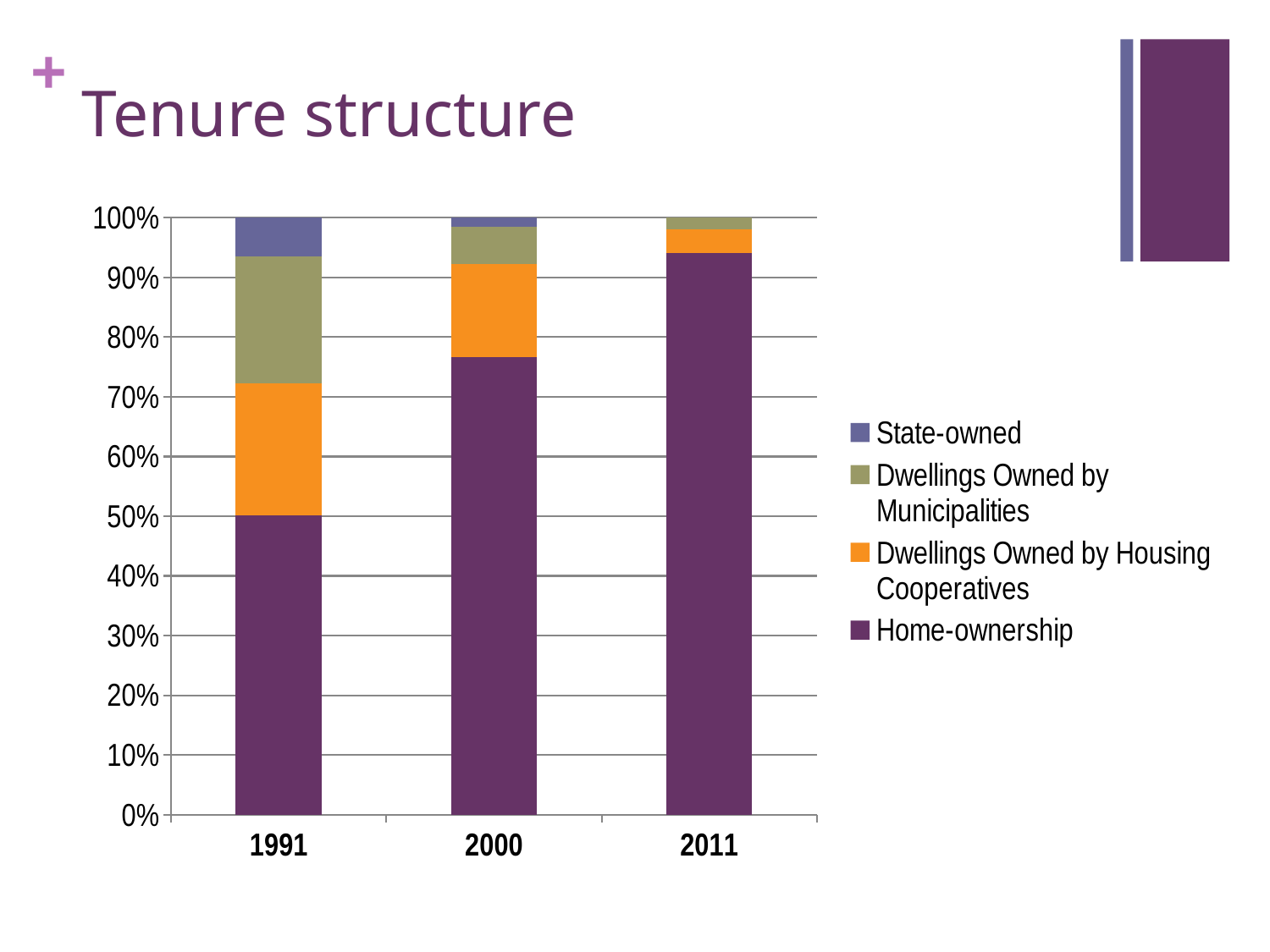
Which year has the larger State-owned share, 1991 or 2000? 1991 What is the title of the slide containing the chart? Tenure structure Which series is shown in orange in the chart? Dwellings Owned by Housing Cooperatives What kind of chart is shown on the slide? stacked bar chart In which year is the Home-ownership share the lowest? 1991 In which year is the Home-ownership share the highest? 2011 How many years (categories) are shown on the x axis of the chart? 3 Is the Home-ownership share in 2000 greater or less than 70%? greater How many series does the chart's legend list? 4 Is the Home-ownership share in 1991 greater or less than 60%? less Is the Home-ownership share in 2011 greater or less than 90%? greater Does the Home-ownership share rise or fall from 1991 to 2011? rise